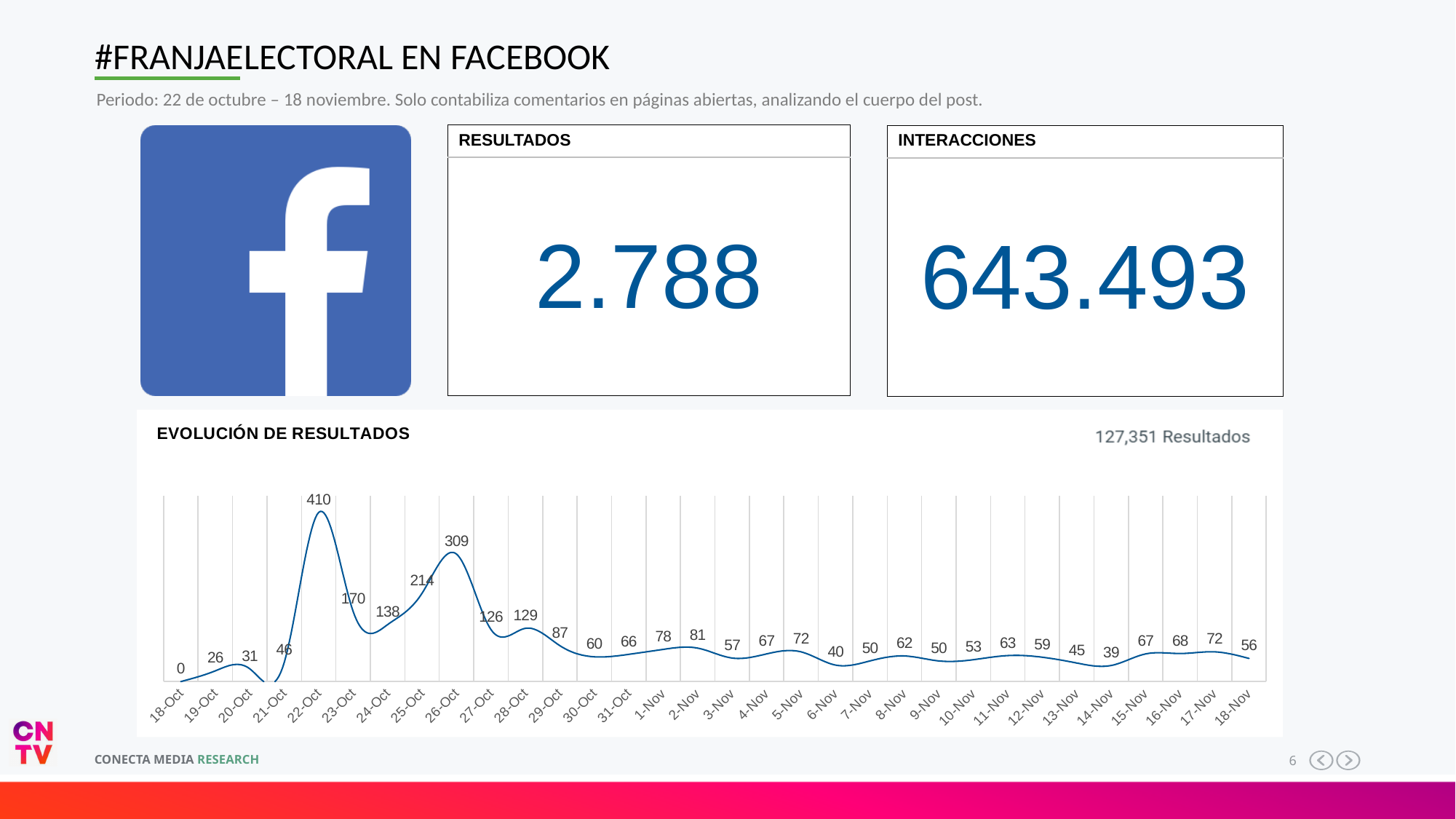
On which date does the 'EVOLUCIÓN DE RESULTADOS' chart reach its highest value? 22-Oct What kind of chart is shown under 'EVOLUCIÓN DE RESULTADOS'? Line chart What is the value for 18-Oct on the 'EVOLUCIÓN DE RESULTADOS' chart? 0 What is the difference between the values for 22-Oct and 26-Oct on the 'EVOLUCIÓN DE RESULTADOS' chart? 101 How many dates are plotted on the 'EVOLUCIÓN DE RESULTADOS' chart? 32 What is the value for 26-Oct on the 'EVOLUCIÓN DE RESULTADOS' chart? 309 What is the value for 18-Nov on the 'EVOLUCIÓN DE RESULTADOS' chart? 56 What is the value for 6-Nov on the 'EVOLUCIÓN DE RESULTADOS' chart? 40 What is the highest value shown on the 'EVOLUCIÓN DE RESULTADOS' chart? 410 Do the values on the 'EVOLUCIÓN DE RESULTADOS' chart rise or fall from 22-Oct to 24-Oct? Fall What is the title of the chart on the slide? EVOLUCIÓN DE RESULTADOS Which date has the larger value on the 'EVOLUCIÓN DE RESULTADOS' chart, 23-Oct or 25-Oct? 25-Oct